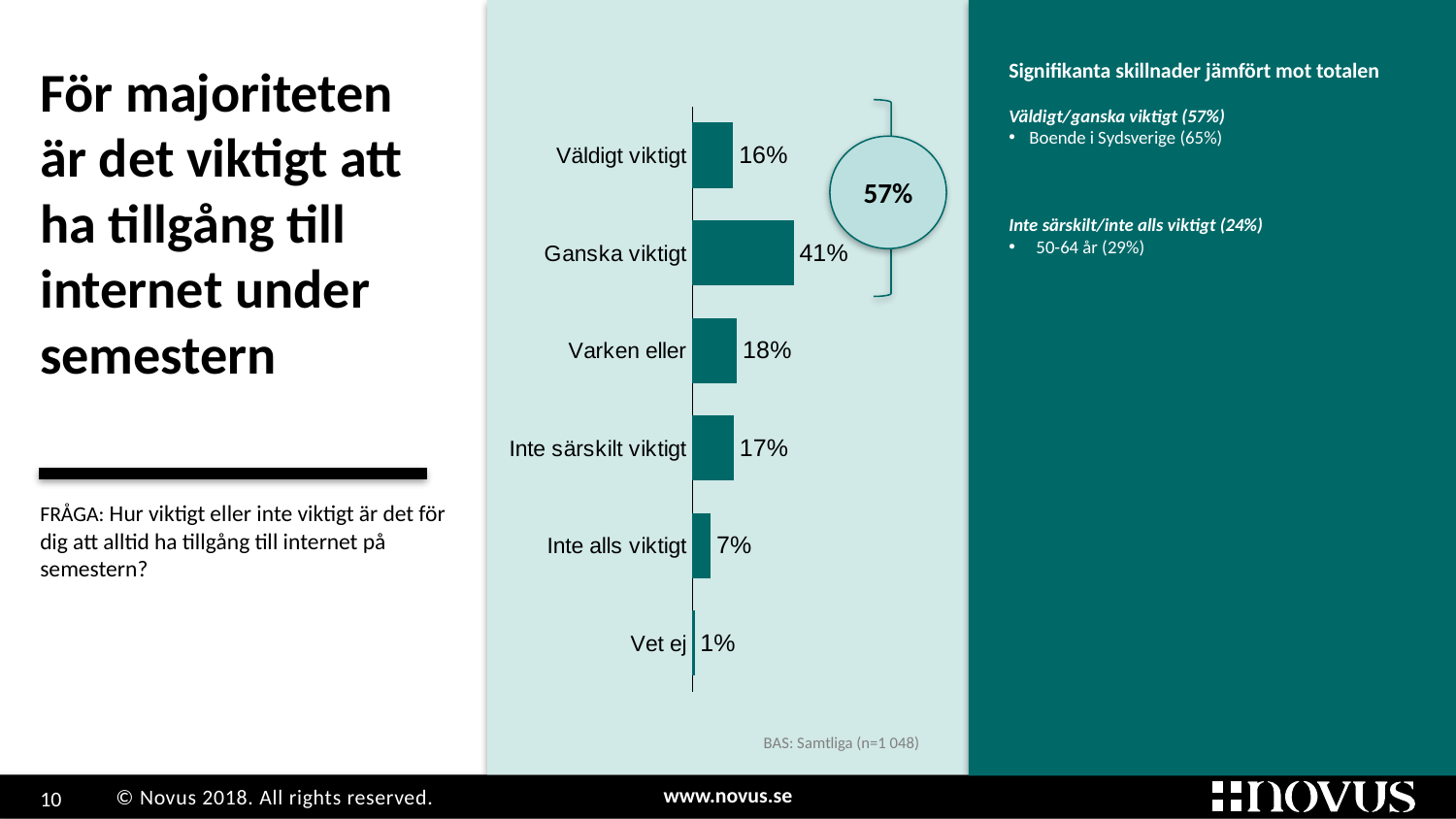
Which is larger, "Varken eller" or "Inte särskilt viktigt"? Varken eller What is the difference between "Ganska viktigt" and "Väldigt viktigt"? 25% How many categories are shown in the chart? 6 What is the value for "Inte alls viktigt"? 7% What is the value for "Vet ej"? 1% What kind of chart is shown on the slide? Bar chart What is the value for "Väldigt viktigt"? 16% What is the value for "Ganska viktigt"? 41% Which category has the lowest value? Vet ej What is the combined value of "Väldigt viktigt" and "Ganska viktigt" shown in the circle? 57% What is the base (BAS) sample size noted below the chart? n=1 048 Which category has the highest value? Ganska viktigt